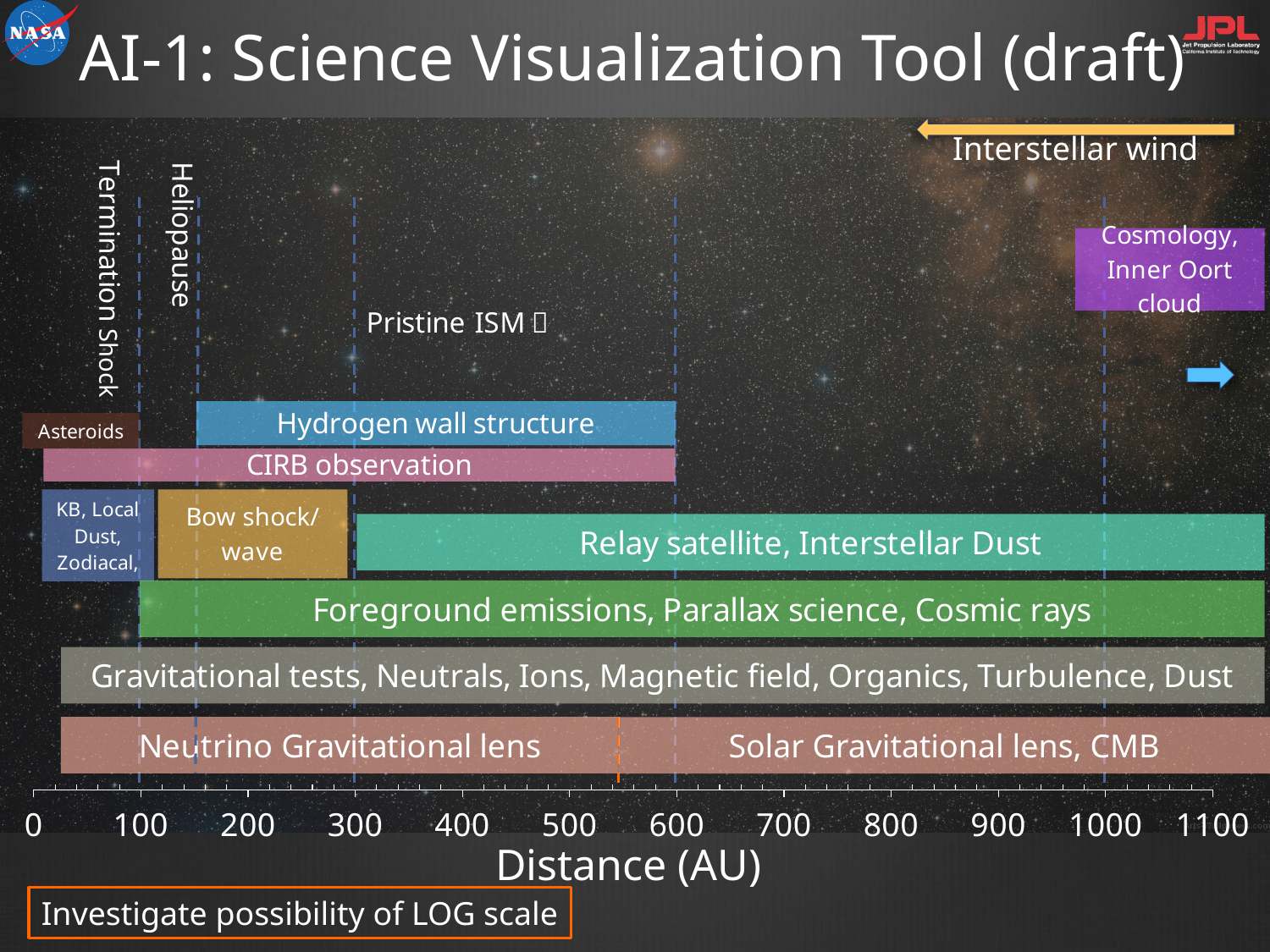
At what distance does the Foreground emissions, Parallax science, Cosmic rays bar begin? 100 What is the title of the horizontal axis of the chart? Distance (AU) At what distance on the axis is the Termination Shock dashed line placed? 100 Which bar covers a wider range of distances, Hydrogen wall structure or Relay satellite, Interstellar Dust? Relay satellite, Interstellar Dust What kind of chart is shown on the slide? bar chart Is the end of the Bow shock/wave bar greater or less than 400 AU? less At what distance does the Relay satellite, Interstellar Dust bar begin? 300 What is the largest tick value shown on the distance axis? 1100 At what distance does the Hydrogen wall structure bar end? 600 Is the end of the Neutrino Gravitational lens bar greater or less than 500 AU? greater